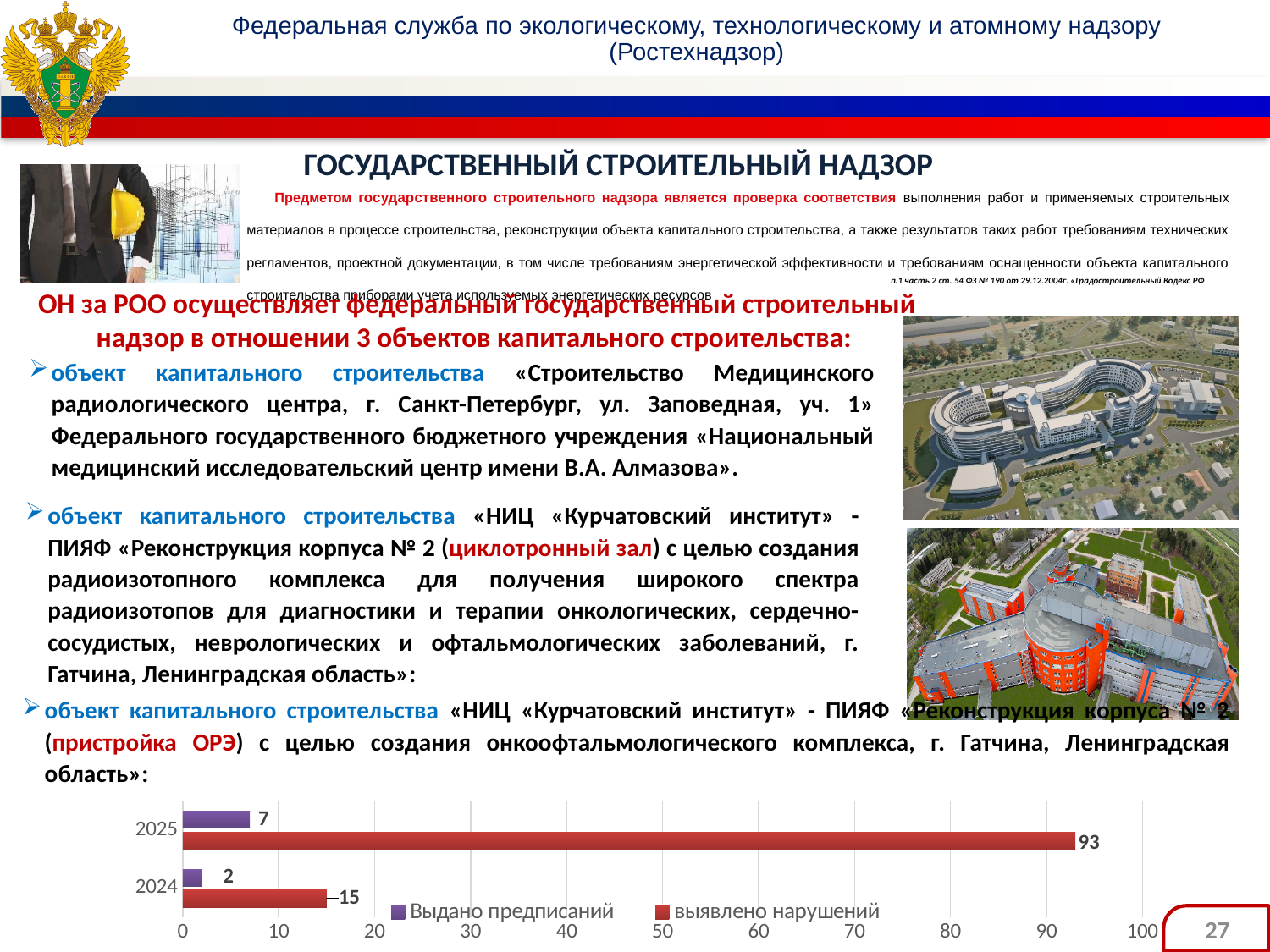
What type of chart is shown at the bottom of the slide? bar chart Which year has the higher value for «выявлено нарушений»? 2025 What are the two series named in the chart legend? Выдано предписаний; выявлено нарушений What is the difference between «выявлено нарушений» in 2025 and in 2024? 78 What is the value of «выявлено нарушений» for 2024? 15 What is the value of «Выдано предписаний» for 2025? 7 What is the value of «Выдано предписаний» for 2024? 2 How many series does the chart legend list? 2 What is the value of «выявлено нарушений» for 2025? 93 Which colour represents the series «выявлено нарушений» in the chart? red What is the difference between «Выдано предписаний» in 2025 and in 2024? 5 How many years (categories) are shown on the chart? 2